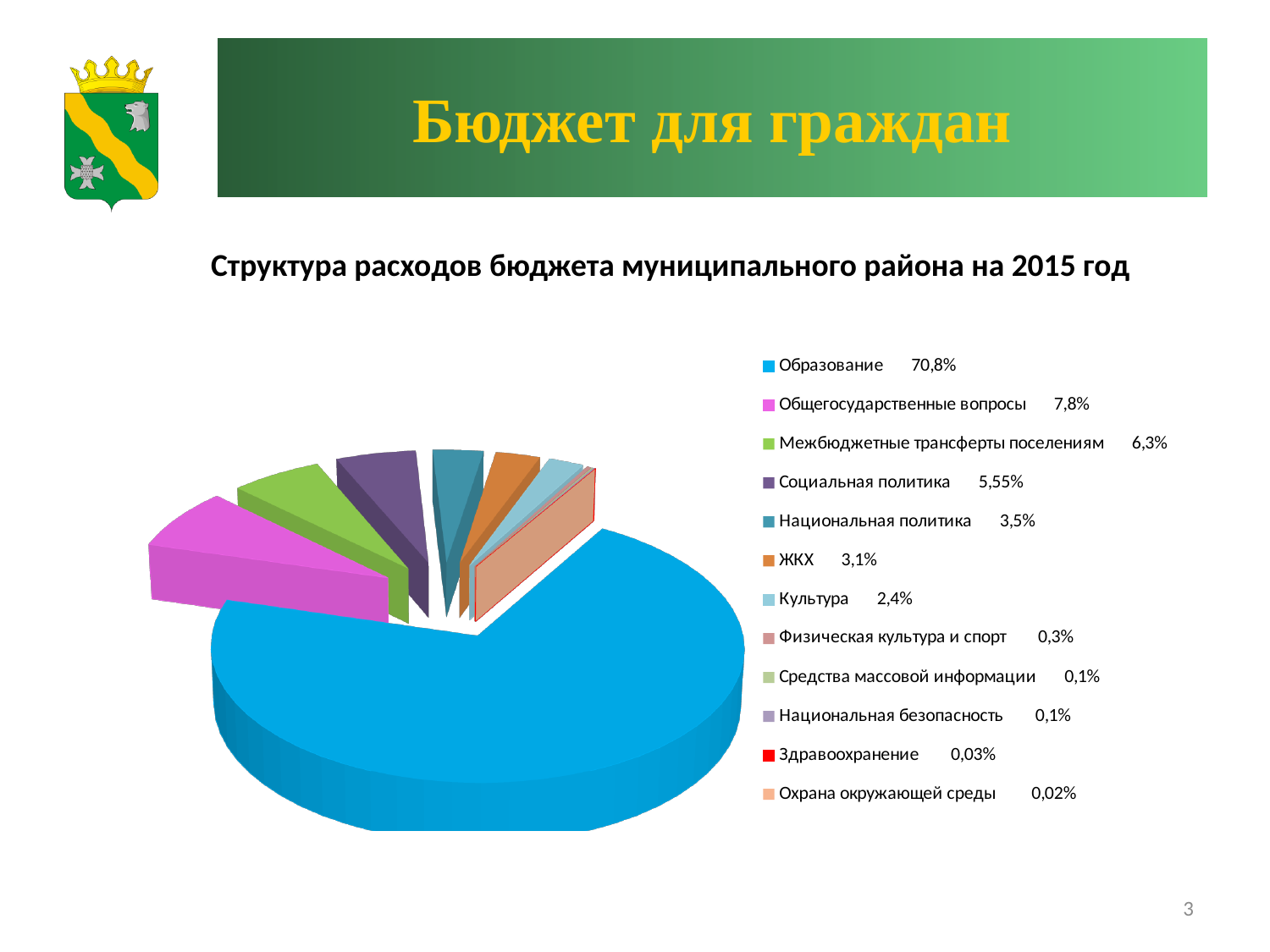
What is the value for ЖКХ? 3,1% How many categories does the legend list? 12 What is the title of the chart? Структура расходов бюджета муниципального района на 2015 год What share of the pie does Культура represent? 2,4% What is the value for Здравоохранение? 0,03% What is the value for Общегосударственные вопросы? 7,8% What is the difference between Общегосударственные вопросы and Межбюджетные трансферты поселениям? 1,5% What is the value for Образование? 70,8% Which is larger, Социальная политика or Национальная политика? Социальная политика What kind of chart is shown on the slide? pie chart Which category has the smallest share of the pie? Охрана окружающей среды Which category has the largest share of the pie? Образование